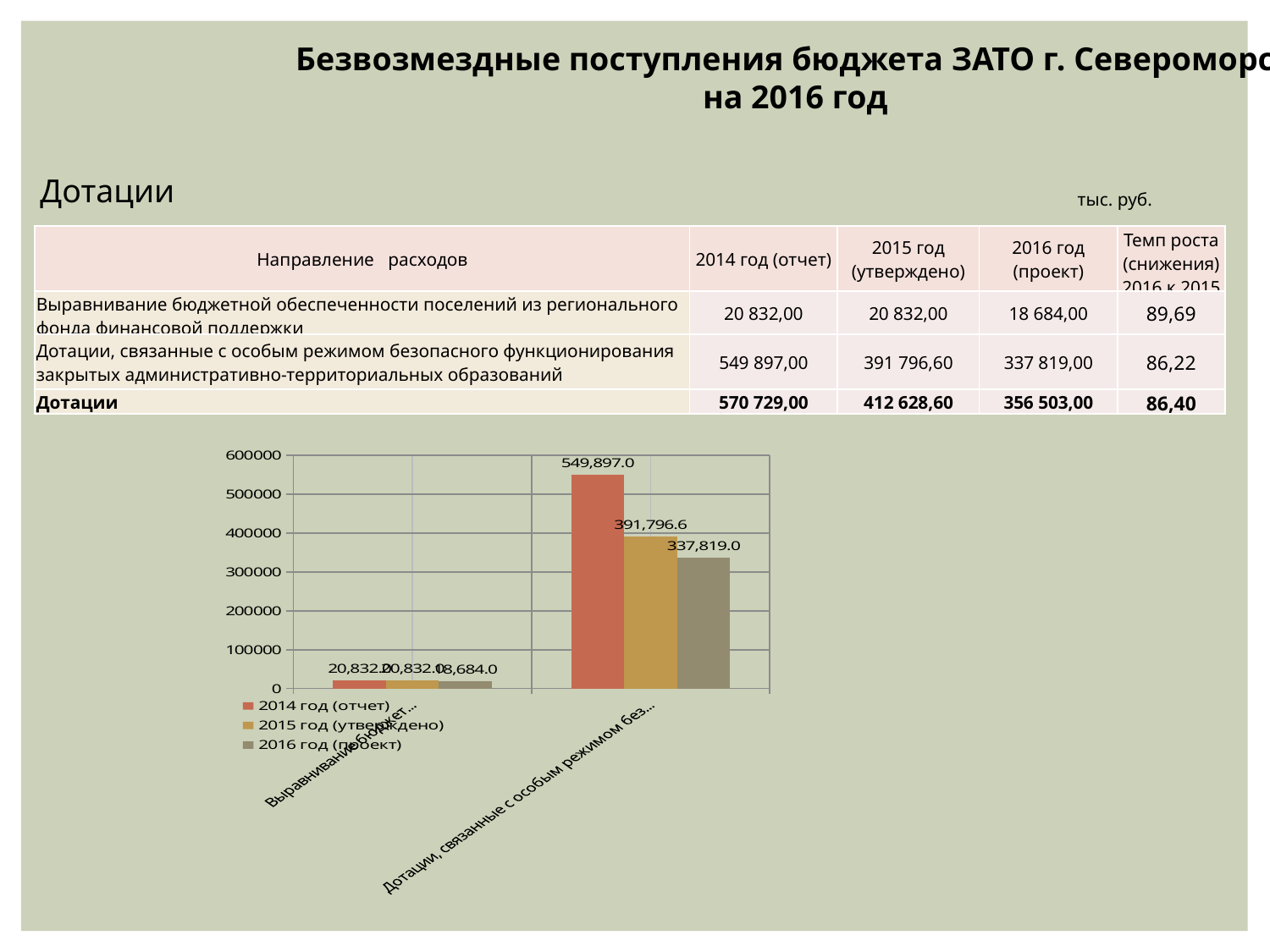
Which series has the highest value for the category 'Дотации, связанные с особым режимом...'? 2014 год (отчет) What is the value of the 2016 год (проект) series for the category 'Дотации, связанные с особым режимом...'? 337,819.0 What kind of chart is shown on the slide? bar chart How many categories are plotted on the x axis of the chart? 2 What colour are the bars of the 2014 год (отчет) series in the chart? red How many series does the chart legend list? 3 What is the difference between the 2014 год (отчет) and 2015 год (утверждено) values for the category 'Дотации, связанные с особым режимом...'? 158,100.4 What is the value of the 2015 год (утверждено) series for the category 'Дотации, связанные с особым режимом...'? 391,796.6 What is the value of the 2014 год (отчет) series for the category 'Дотации, связанные с особым режимом...'? 549,897.0 What is the value of the 2016 год (проект) series for the category 'Выравнивание бюджет...'? 18,684.0 Which is larger for the category 'Дотации, связанные с особым режимом...': the 2015 год (утверждено) value or the 2016 год (проект) value? 2015 год (утверждено) Do the values for the category 'Дотации, связанные с особым режимом...' rise or fall from the 2014 series to the 2016 series? fall